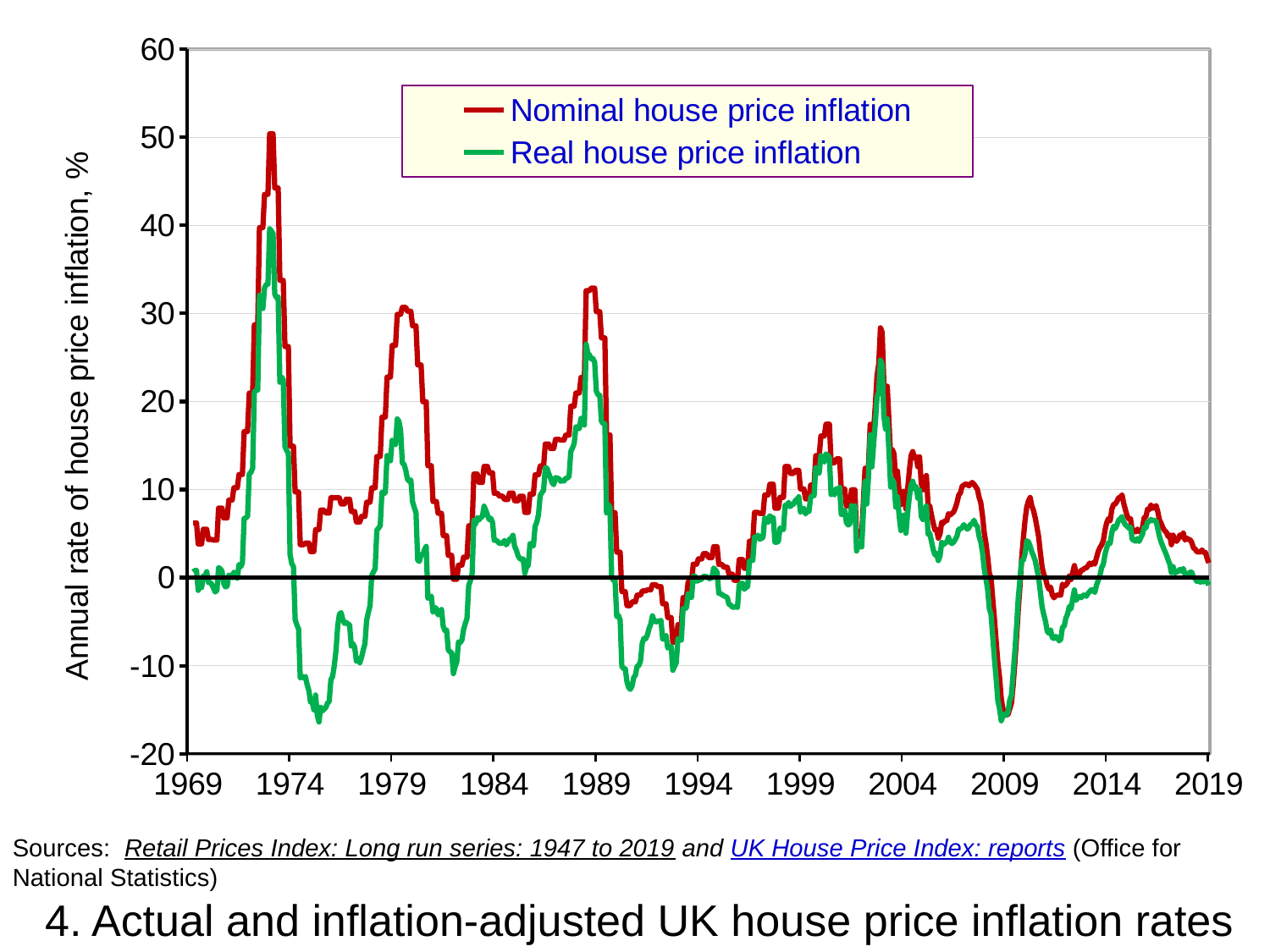
Does Nominal house price inflation rise or fall between 1969 and its peak in the early 1970s? Rise Is the peak value of Nominal house price inflation around 1989 greater or less than 30? greater What kind of chart is shown on the slide? Line chart What are the two series named in the legend? Nominal house price inflation and Real house price inflation What is the label on the vertical axis? Annual rate of house price inflation, % Is the lowest value of Real house price inflation in the mid-1970s greater or less than -10? less Is the lowest value of Nominal house price inflation around 2009 greater or less than -10? less How many series does the legend list? 2 Which series reaches the higher peak in the early 1970s, Nominal house price inflation or Real house price inflation? Nominal house price inflation In which period does Nominal house price inflation reach its highest value: the early 1970s, the late 1980s, or the early 2000s? Early 1970s